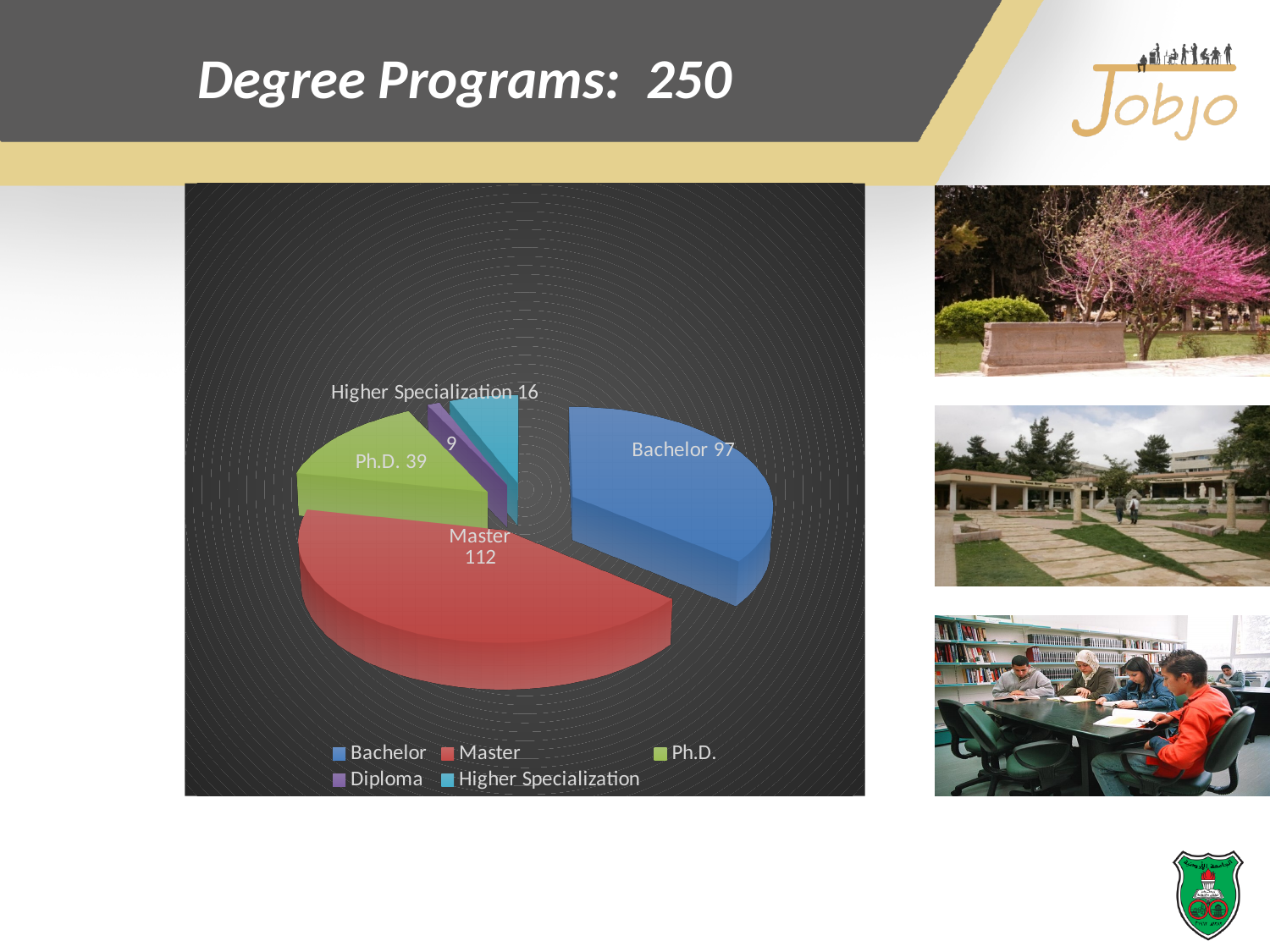
Which is larger, the value for Ph.D. or the value for Higher Specialization? Ph.D. How many more Master programs are there than Bachelor programs? 15 What is the value shown for Ph.D. in the pie chart? 39 How many categories does the pie chart show? 5 What is the value shown for Diploma in the pie chart? 9 What colour is the Master slice in the pie chart? red Which category has the smallest slice in the pie chart? Diploma How many degree programs are Master programs according to the chart? 112 What is the value shown for Higher Specialization in the pie chart? 16 Which category has the largest slice in the pie chart? Master What is the value shown for Bachelor in the pie chart? 97 What kind of chart is shown on the slide? pie chart